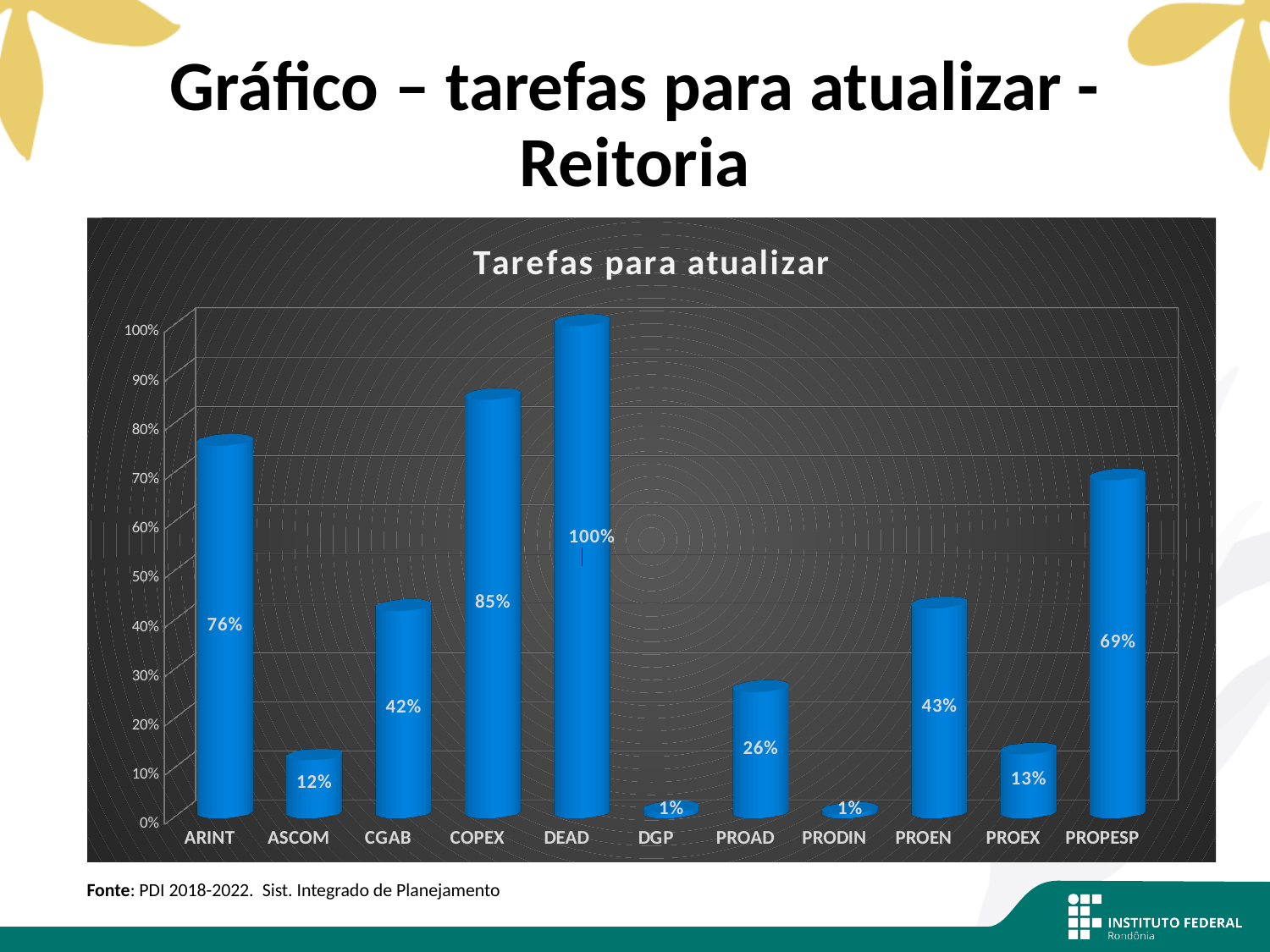
How many categories are shown on the x axis? 11 Which is larger, the value for CGAB or the value for PROEX? CGAB Which category has the highest value? DEAD What is the title of the chart? Tarefas para atualizar What is the value for DEAD? 100% What is the difference between the values for PROEN and PROAD? 17% What is the value for ASCOM? 12% What is the difference between the values for COPEX and ARINT? 9% What is the value for PROPESP? 69% What kind of chart is shown? Bar chart Which is larger, the value for PROPESP or the value for COPEX? COPEX Is the value for ARINT greater or less than 70%? greater